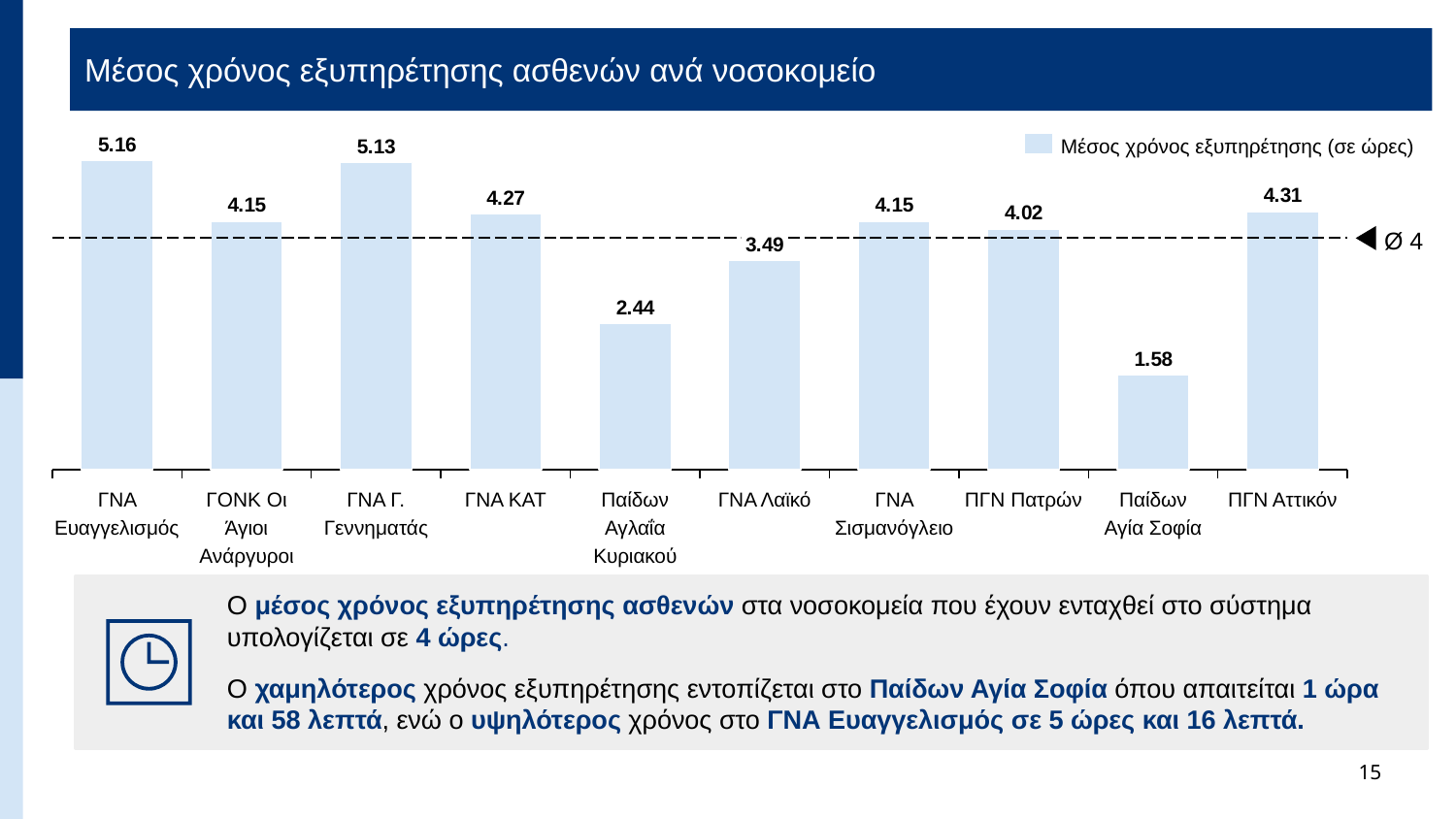
Which is larger, the value for ΓΝΑ ΚΑΤ or the value for ΠΓΝ Πατρών? ΓΝΑ ΚΑΤ Is the value for ΓΝΑ Λαϊκό greater or less than the dashed average line of 4? less What type of chart is shown on the slide? bar chart What is the average service time for ΓΝΑ Ευαγγελισμός? 5.16 What is the difference between the values for ΓΝΑ Ευαγγελισμός and Παίδων Αγία Σοφία? 3.58 What is the value shown for ΓΝΑ Λαϊκό? 3.49 What is the value shown for Παίδων Αγλαΐα Κυριακού? 2.44 What is the value shown for ΠΓΝ Αττικόν? 4.31 How many hospitals are shown in the chart? 10 Which hospital has the highest average service time? ΓΝΑ Ευαγγελισμός What value does the dashed horizontal line on the chart mark? 4 Which hospital has the lowest average service time? Παίδων Αγία Σοφία